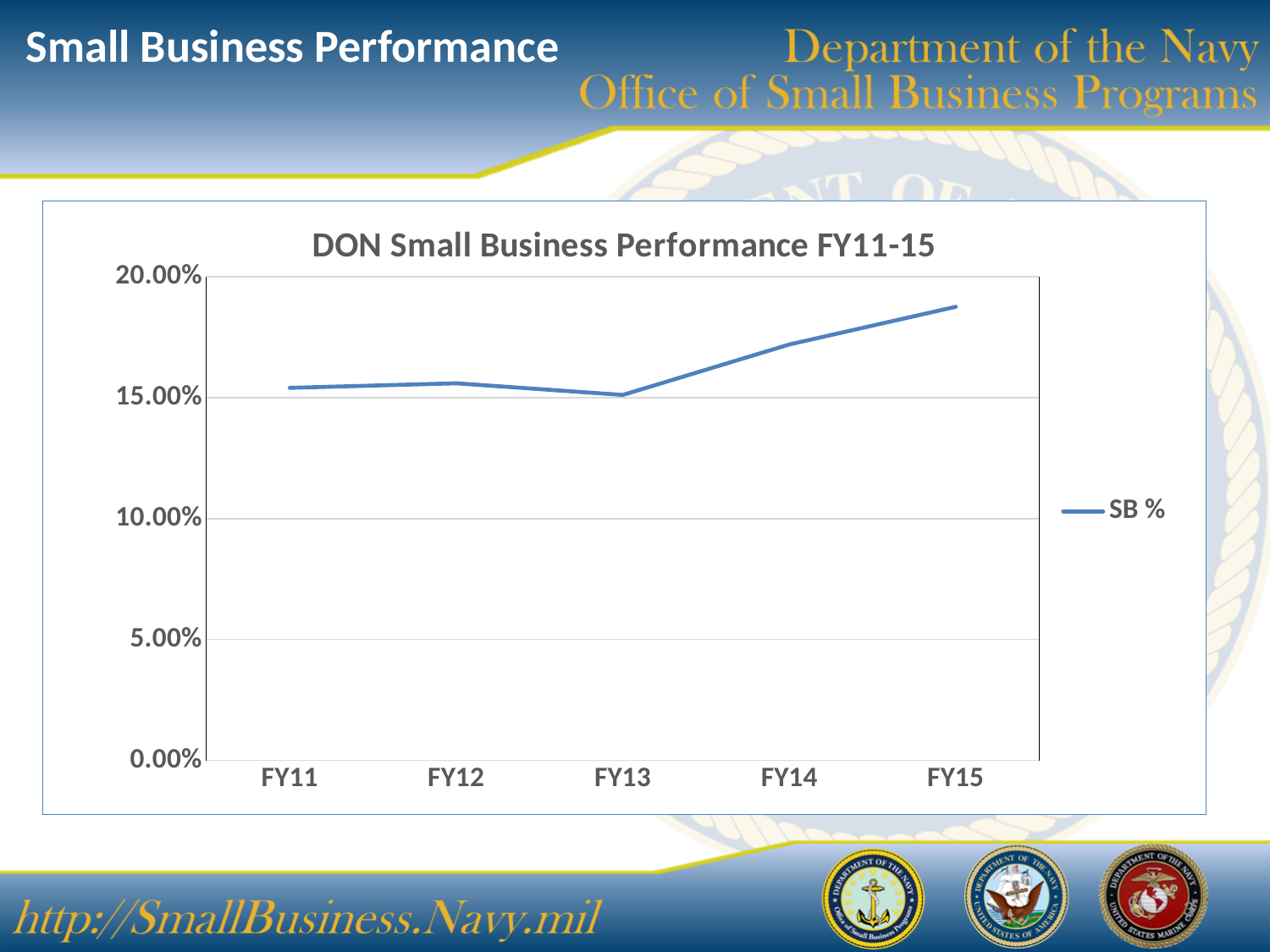
Is the SB % value for FY14 greater or less than 15.00%? greater How many fiscal years are plotted on the x axis? 5 How many series does the legend list? 1 Is the SB % value for FY15 greater or less than 15.00%? greater Is the SB % value for FY11 greater or less than 10.00%? greater Which is larger, the SB % value for FY15 or for FY11? FY15 What is the title of the chart? DON Small Business Performance FY11-15 What kind of chart is shown on the slide? line chart Which fiscal year has the highest SB % value? FY15 What series name does the legend list? SB % Does the SB % value rise or fall from FY13 to FY15? rise